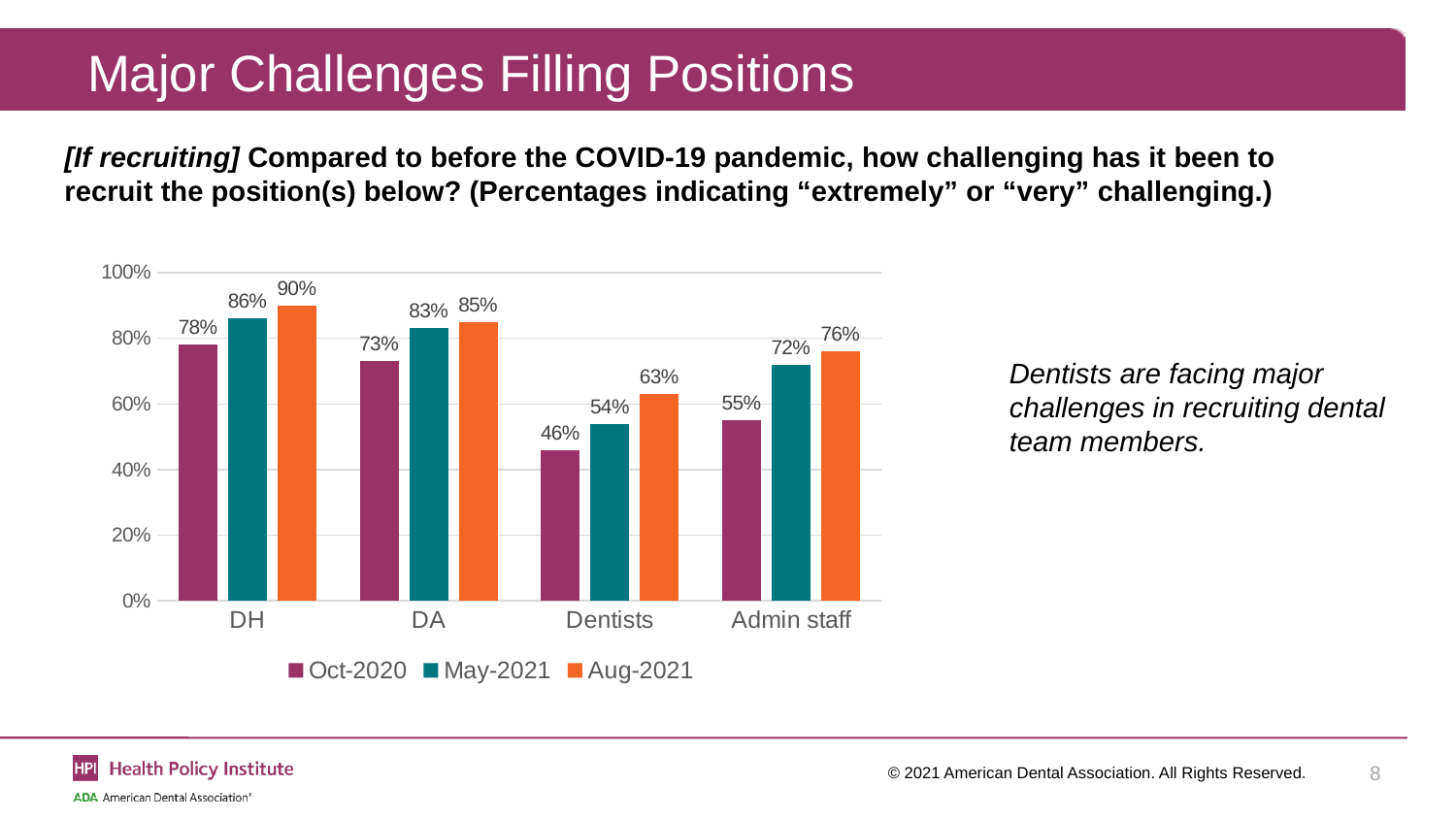
What is the May-2021 value for Admin staff? 72% Which is larger, the May-2021 value for DA or the May-2021 value for Admin staff? DA What kind of chart is shown on the slide? bar chart Which category has the highest Aug-2021 value? DH Which category has the lowest Oct-2020 value? Dentists What is the difference between the Aug-2021 and Oct-2020 values for Dentists? 17% How many categories are shown on the x axis? 4 Do the values for Dentists rise or fall from Oct-2020 to Aug-2021? rise What is the Aug-2021 value for DH? 90% How many series does the legend list? 3 What is the Oct-2020 value for Dentists? 46% Is the Oct-2020 value for Admin staff greater or less than 60%? less